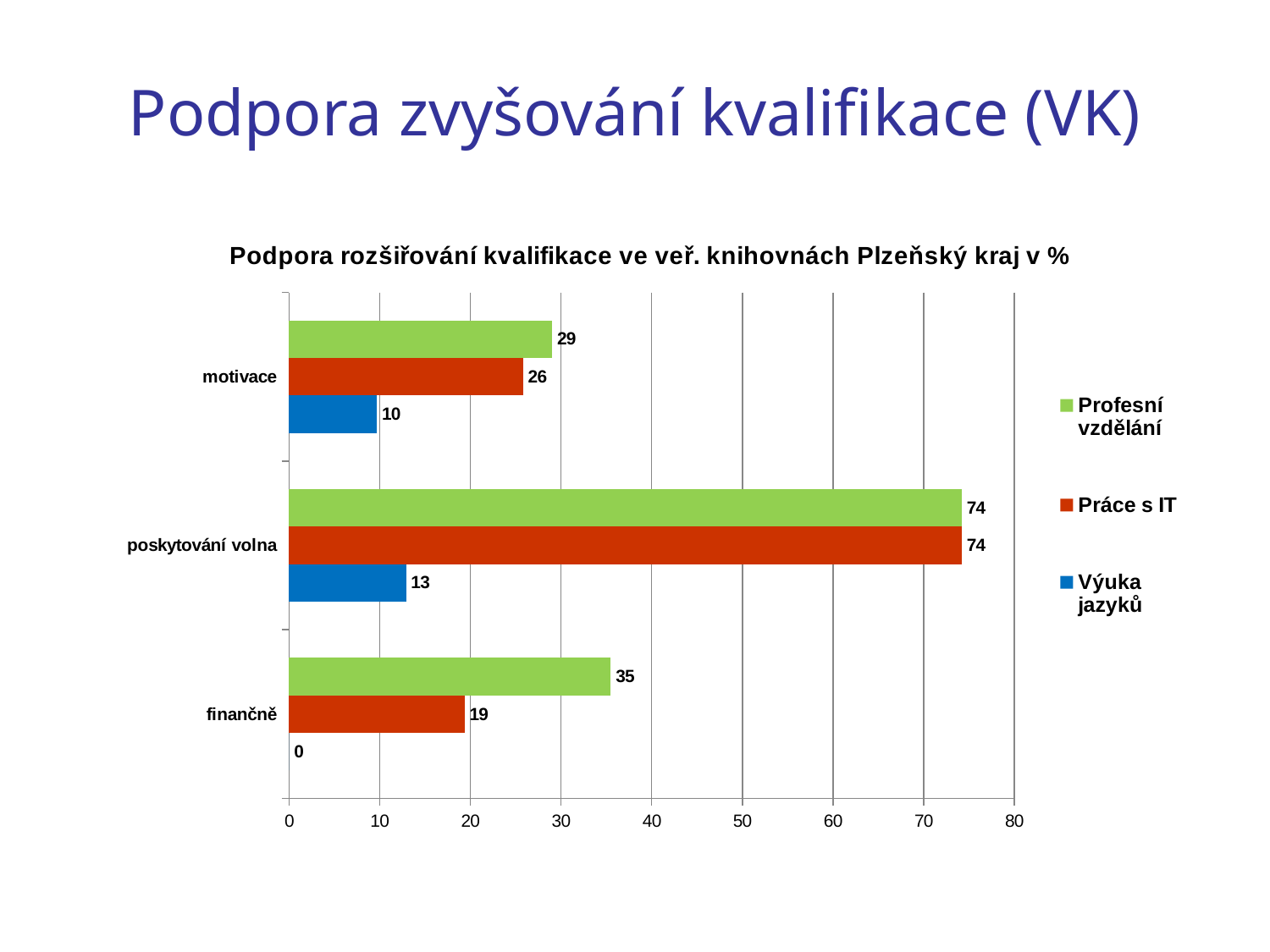
How many categories are shown on the y axis? 3 Which category has the highest value for Výuka jazyků? poskytování volna Which category has the lowest value for Práce s IT? finančně Which is larger in the motivace category: Profesní vzdělání or Výuka jazyků? Profesní vzdělání What kind of chart is shown? bar chart What is the value for Práce s IT in the poskytování volna category? 74 What is the difference between Profesní vzdělání and Práce s IT in the finančně category? 16 Is the value for Profesní vzdělání in poskytování volna greater or less than 70? greater What is the value for Profesní vzdělání in the motivace category? 29 What is the title of the chart? Podpora rozšiřování kvalifikace ve veř. knihovnách Plzeňský kraj v % How many series does the legend list? 3 What is the value for Výuka jazyků in the finančně category? 0